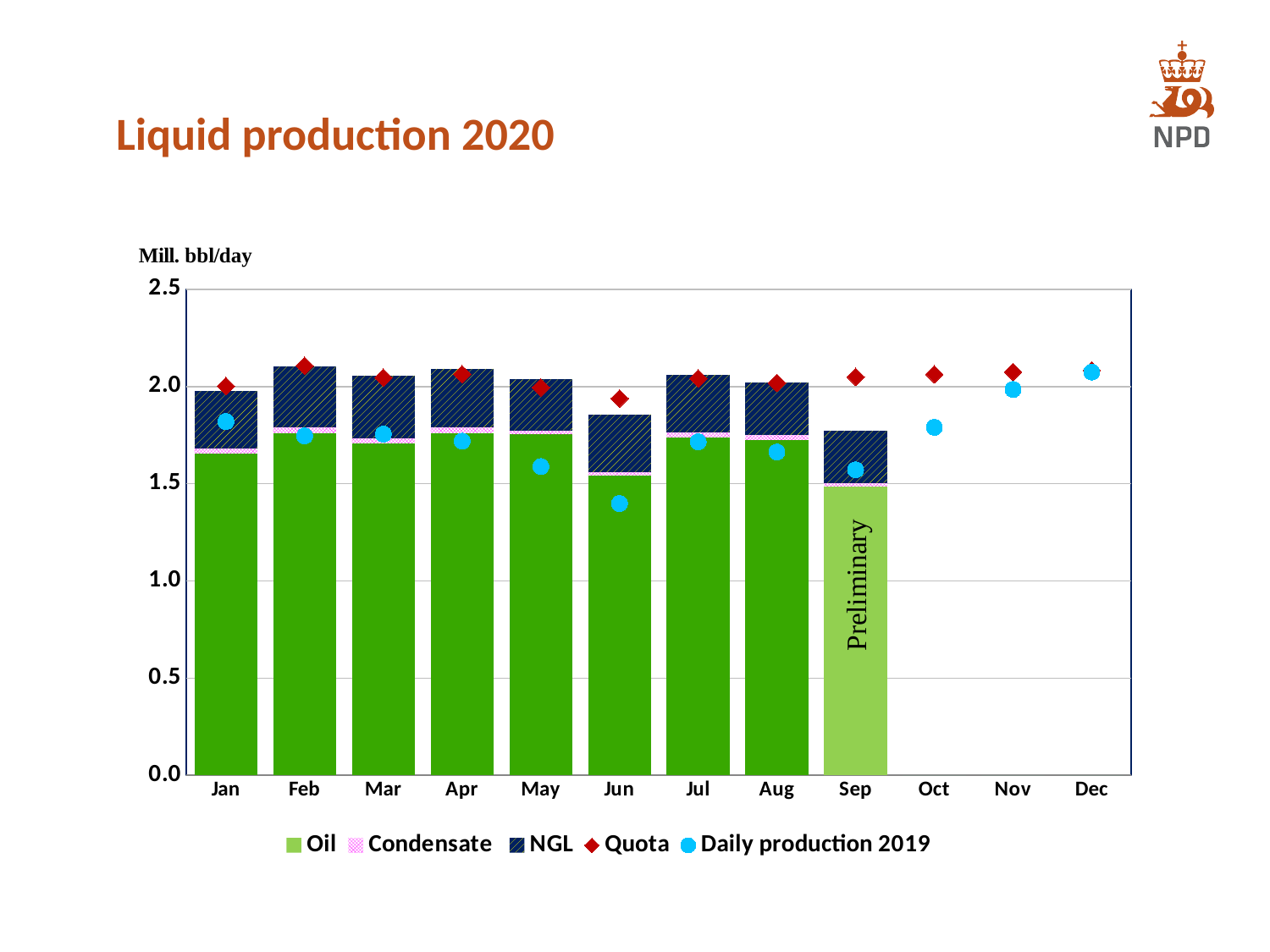
Is the total liquid production bar for Feb greater or less than 2.0? greater How many months are shown on the x axis? 12 Is the Daily production 2019 value for Dec greater or less than 2.0? greater Is the total liquid production bar for Jun greater or less than 2.0? less Does the Daily production 2019 series rise or fall from Sep to Dec? rise Which month's bar is labelled 'Preliminary'? Sep Which is larger, the total production bar for Jun or for Jul? Jul How many series does the legend list? 5 How many months have a production bar plotted? 9 What kind of chart is shown on the slide? Stacked bar chart with markers Among Jan to Aug, which month has the lowest total liquid production bar? Jun